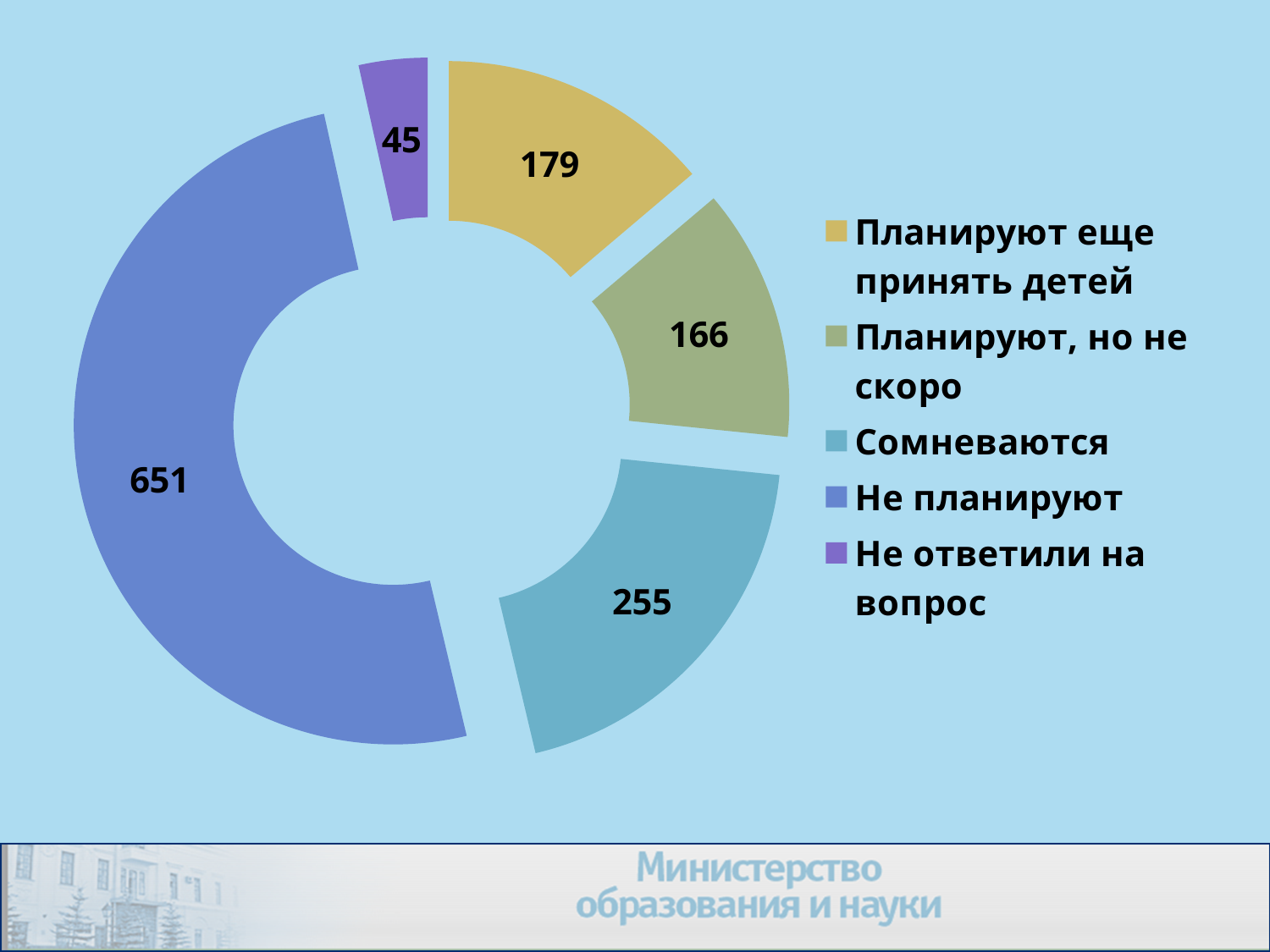
What kind of chart is shown on the slide? doughnut chart What value is shown for the category "Планируют еще принять детей"? 179 What value is shown for the category "Сомневаются"? 255 Which is larger: the value for "Сомневаются" or the value for "Планируют еще принять детей"? Сомневаются Which category has the smallest value? Не ответили на вопрос What value is shown for the category "Не ответили на вопрос"? 45 What value is shown for the category "Не планируют"? 651 What is the difference between the values for "Не планируют" and "Сомневаются"? 396 What is the difference between the values for "Планируют еще принять детей" and "Планируют, но не скоро"? 13 Which category has the largest value? Не планируют How many categories does the chart show? 5 What is the total of all the values shown in the chart? 1296